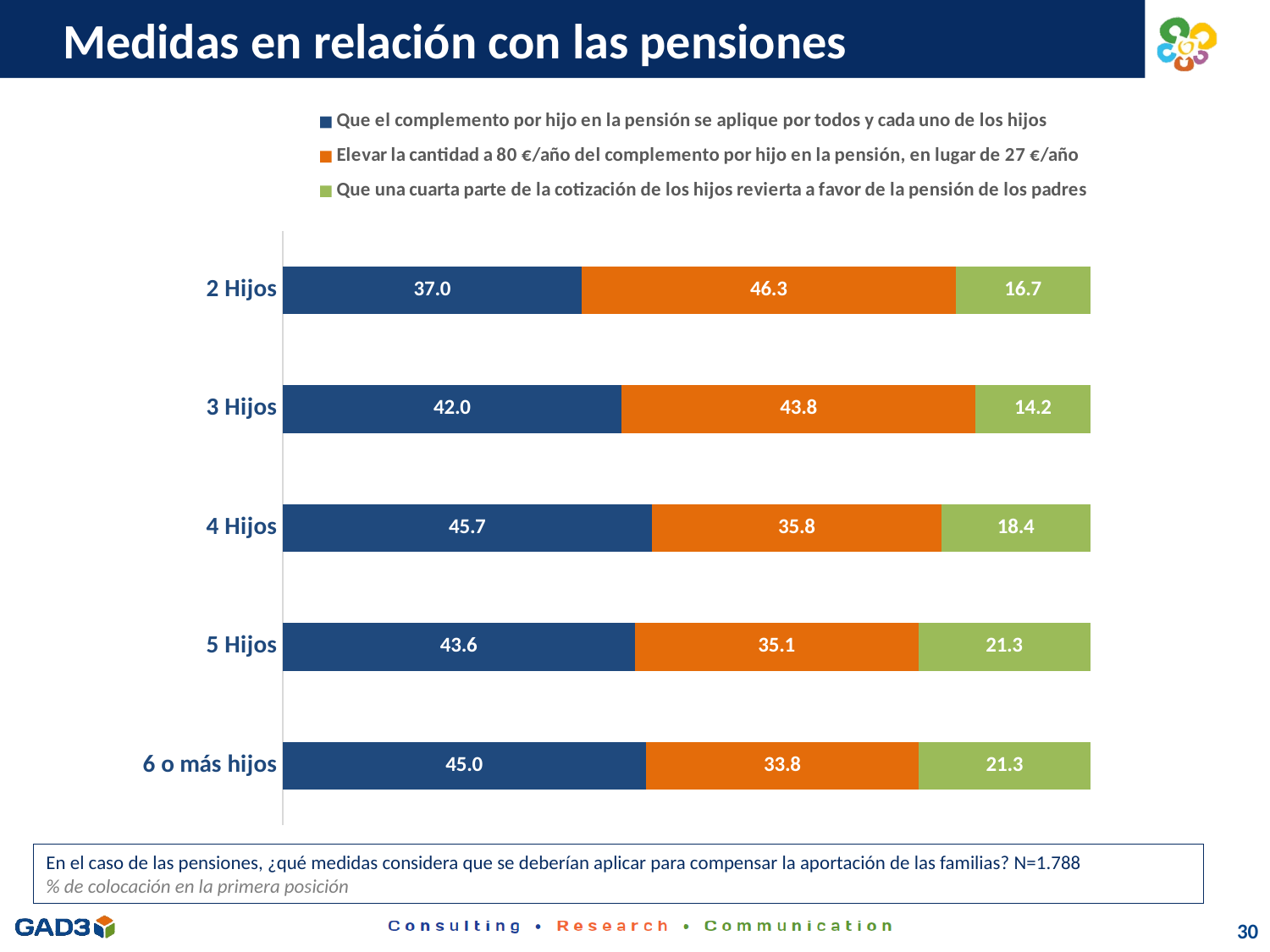
Which category has the lowest value in the series "Que una cuarta parte de la cotización de los hijos revierta a favor de la pensión de los padres"? 3 Hijos For "2 Hijos", what is the difference between the value for "Elevar la cantidad a 80 €/año..." and the value for "Que el complemento por hijo en la pensión se aplique por todos y cada uno de los hijos"? 9.3 For "3 Hijos", which is larger: the value for "Que el complemento por hijo en la pensión se aplique por todos y cada uno de los hijos" or the value for "Elevar la cantidad a 80 €/año del complemento por hijo en la pensión, en lugar de 27 €/año"? Elevar la cantidad a 80 €/año del complemento por hijo en la pensión, en lugar de 27 €/año How many series does the legend list? 3 Which category has the highest value in the series "Que el complemento por hijo en la pensión se aplique por todos y cada uno de los hijos"? 4 Hijos What is the value for "2 Hijos" in the series "Que el complemento por hijo en la pensión se aplique por todos y cada uno de los hijos"? 37.0 What kind of chart is shown on the slide? Stacked bar chart How many categories are shown on the chart? 5 Which category has the highest value in the series "Elevar la cantidad a 80 €/año del complemento por hijo en la pensión, en lugar de 27 €/año"? 2 Hijos What is the value for "5 Hijos" in the series "Que una cuarta parte de la cotización de los hijos revierta a favor de la pensión de los padres"? 21.3 What is the total of the stacked bar for "4 Hijos"? 99.9 What is the value for "4 Hijos" in the series "Elevar la cantidad a 80 €/año del complemento por hijo en la pensión, en lugar de 27 €/año"? 35.8